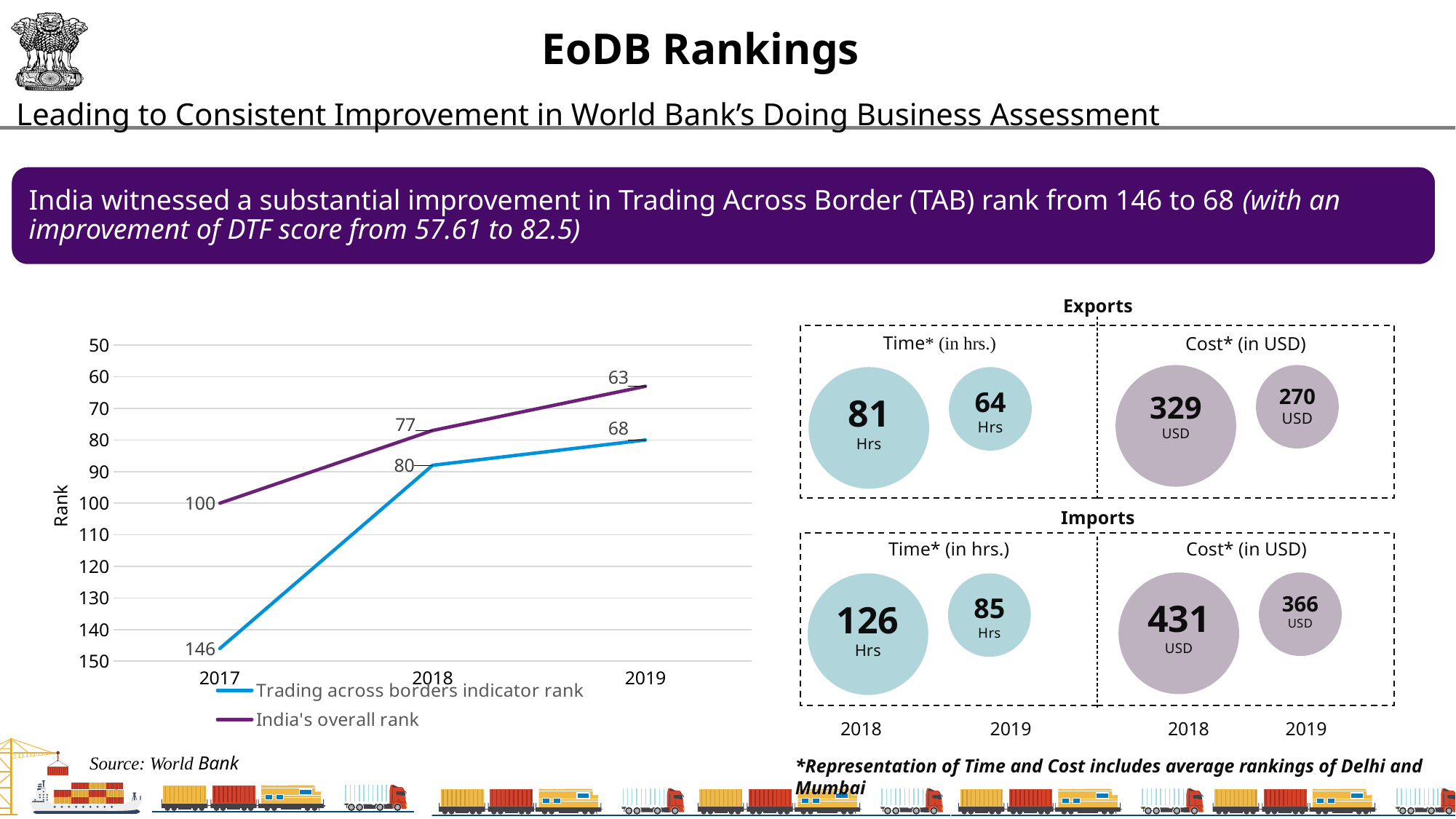
In the line chart, what is the Trading across borders indicator rank for 2018? 80 In the line chart, what is the difference between the Trading across borders indicator rank and India's overall rank in 2018? 3 In the line chart, what is India's overall rank for 2019? 63 In the line chart, do the Trading across borders indicator rank values rise or fall from 2017 to 2019? fall How many series does the legend of the line chart list? 2 In the line chart, what is India's overall rank for 2017? 100 In the line chart, which series has the higher rank number in 2017, Trading across borders indicator rank or India's overall rank? Trading across borders indicator rank In the line chart, what is the Trading across borders indicator rank for 2017? 146 In the line chart, by how much did the Trading across borders indicator rank value change from 2017 to 2019? 78 How many years are plotted on the x axis of the line chart? 3 What type of chart is shown on the left of the slide? line chart What is the label on the y axis of the line chart? Rank